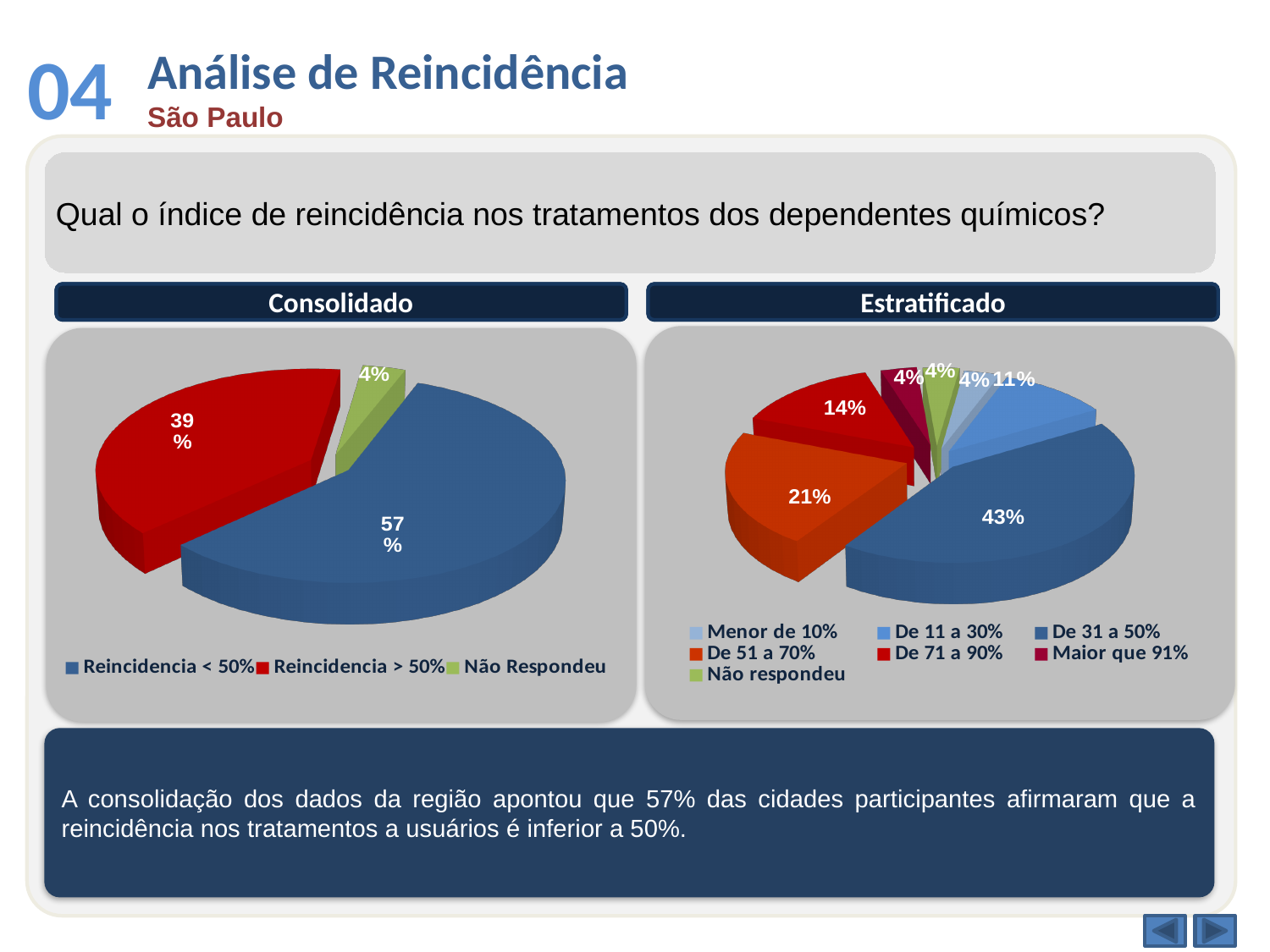
In the Consolidado chart, which category has the smallest slice? Não Respondeu In the Estratificado chart, what is the value for De 31 a 50%? 43% How many categories does the legend of the Consolidado chart list? 3 In the Estratificado chart, what is the value for De 71 a 90%? 14% How many categories does the legend of the Estratificado chart list? 7 In the Consolidado chart, what is the value for Reincidencia < 50%? 57% What kind of chart is the Consolidado chart? pie chart In the Estratificado chart, what is the value for De 51 a 70%? 21% In the Estratificado chart, which category has the largest slice? De 31 a 50% In the Estratificado chart, which is larger: De 11 a 30% or De 51 a 70%? De 51 a 70% In the Consolidado chart, what is the difference between Reincidencia < 50% and Reincidencia > 50%? 18% In the Consolidado chart, what is the value for Reincidencia > 50%? 39%